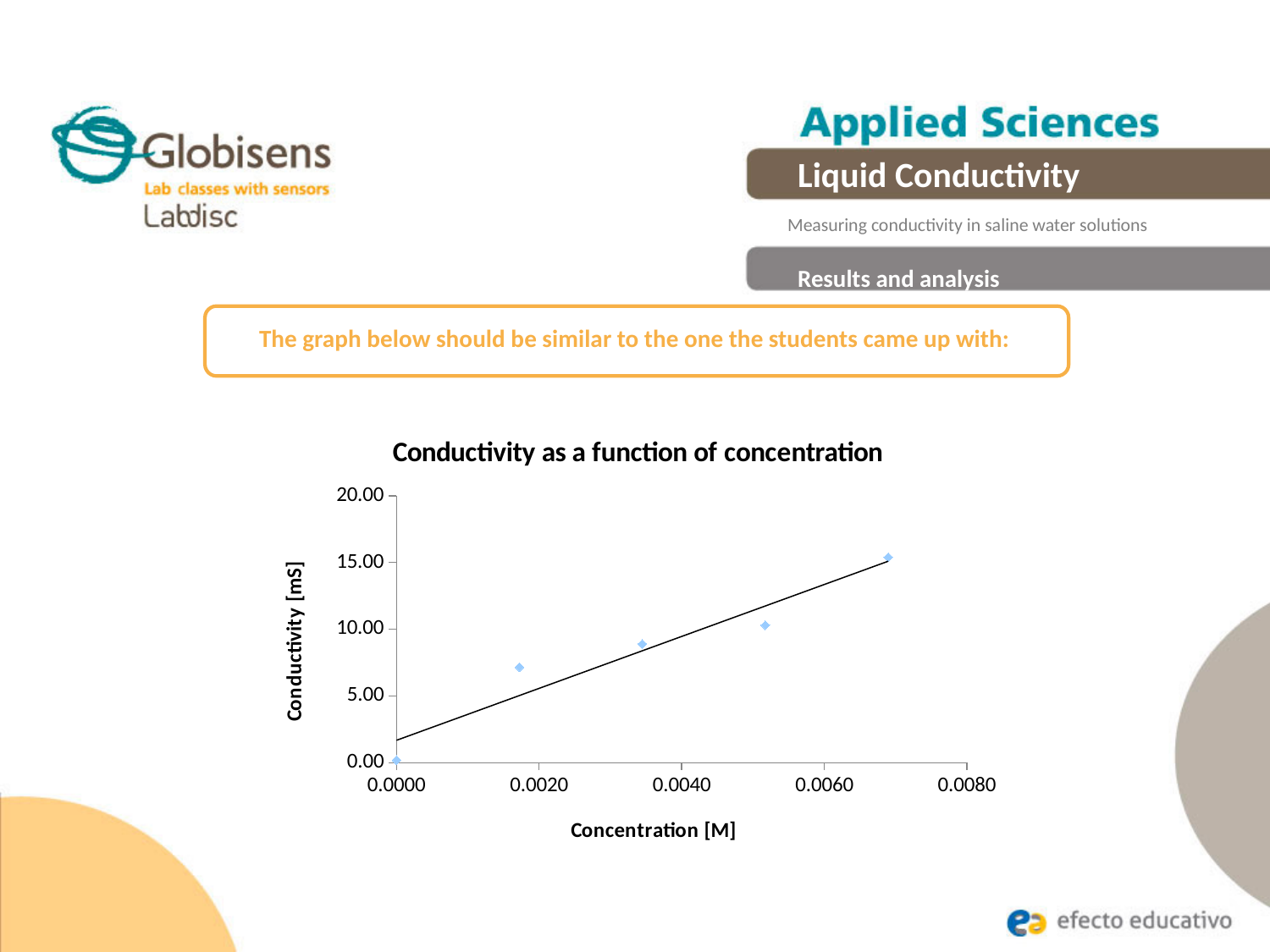
What kind of chart is shown on the slide? Scatter chart Is the conductivity of the point with the highest concentration greater or less than 20.00 mS? less At which concentration does the chart show the lowest conductivity? 0.0000 Is the conductivity of the point near 0.0035 M greater or less than 10.00 mS? less What is the label of the vertical axis of the chart? Conductivity [mS] How many data points are plotted on the chart? 5 What is the title of the chart? Conductivity as a function of concentration Is the conductivity of the point near 0.0020 M greater or less than 5.00 mS? greater Does conductivity rise or fall as concentration increases along the x axis? Rise Which plotted point has the highest conductivity: the one near 0.0052 M or the one near 0.0069 M? The one near 0.0069 M